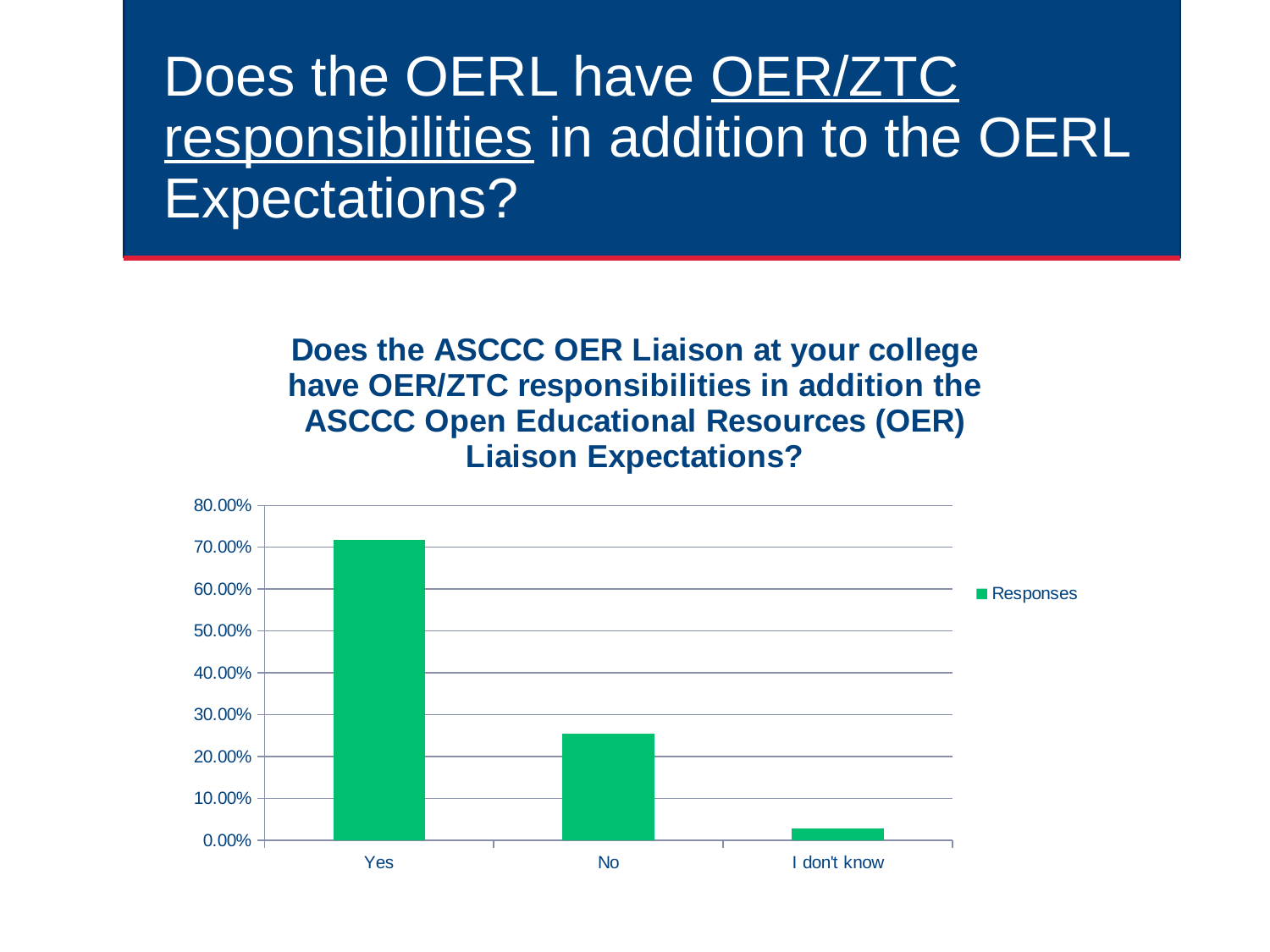
Which category has the lowest value in the chart? I don't know Which is larger, the value for Yes or the value for No? Yes How many series does the chart's legend list? 1 Which category has the highest value in the chart? Yes What is the name of the series shown in the chart's legend? Responses Is the value for No greater or less than 30.00%? less Do the values rise or fall moving from Yes to I don't know along the x axis? fall Is the value for Yes greater or less than 70.00%? greater What is the highest value shown on the chart's y axis? 80.00% What kind of chart is shown on the slide? bar chart How many categories are shown on the x axis of the chart? 3 Is the value for I don't know greater or less than 10.00%? less